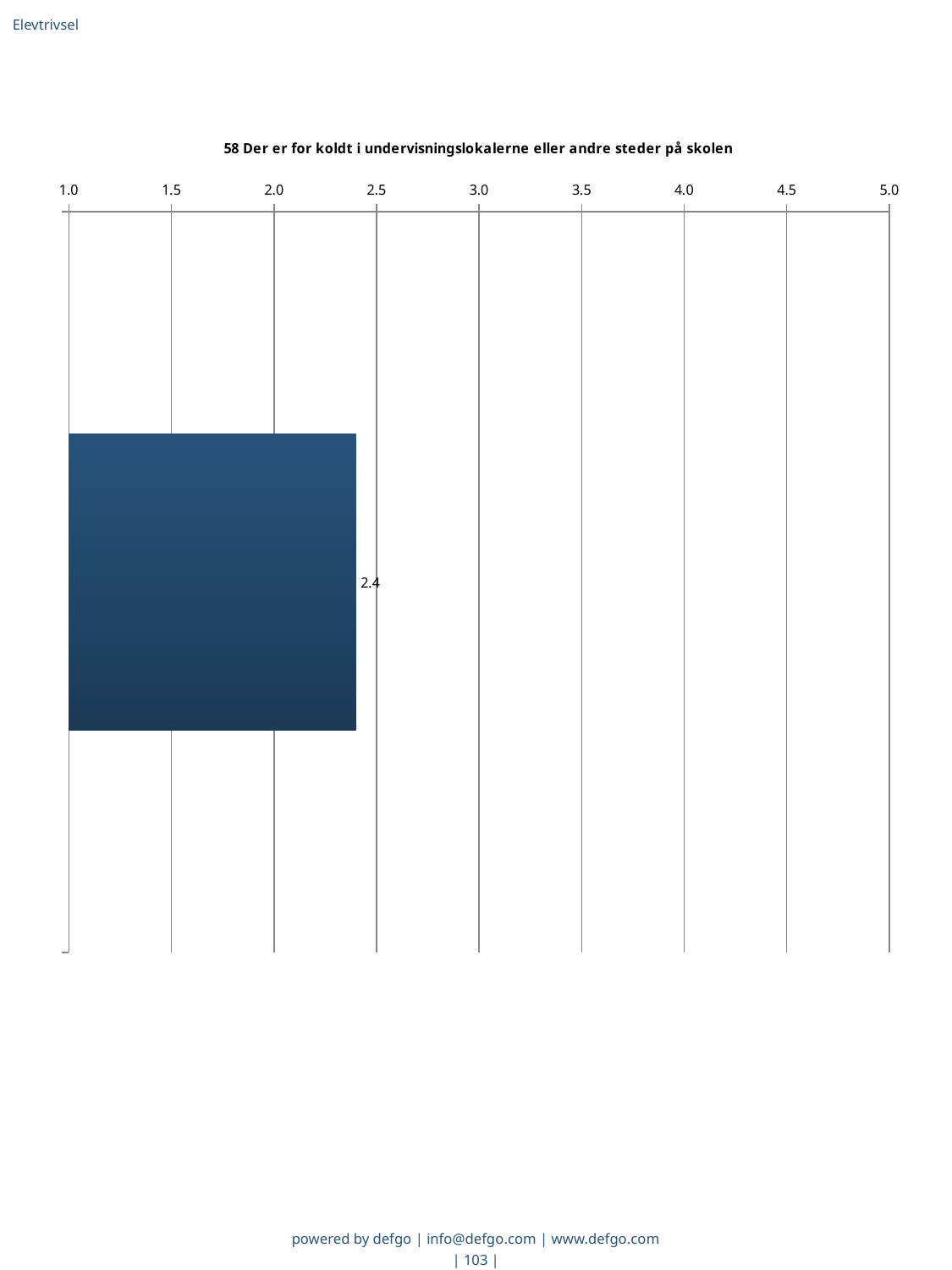
How many bars are plotted in the chart? 1 What is the highest tick value shown on the chart's value axis? 5.0 What value is printed on the bar in the chart? 2.4 Is the value of the bar greater or less than 2.5? less Is the value of the bar greater or less than 3.0? less Is the value of the bar greater or less than 2.0? greater Are the bars in the chart horizontal or vertical? horizontal What kind of chart is shown on the slide? bar chart What is the title of the chart? 58 Der er for koldt i undervisningslokalerne eller andre steder på skolen